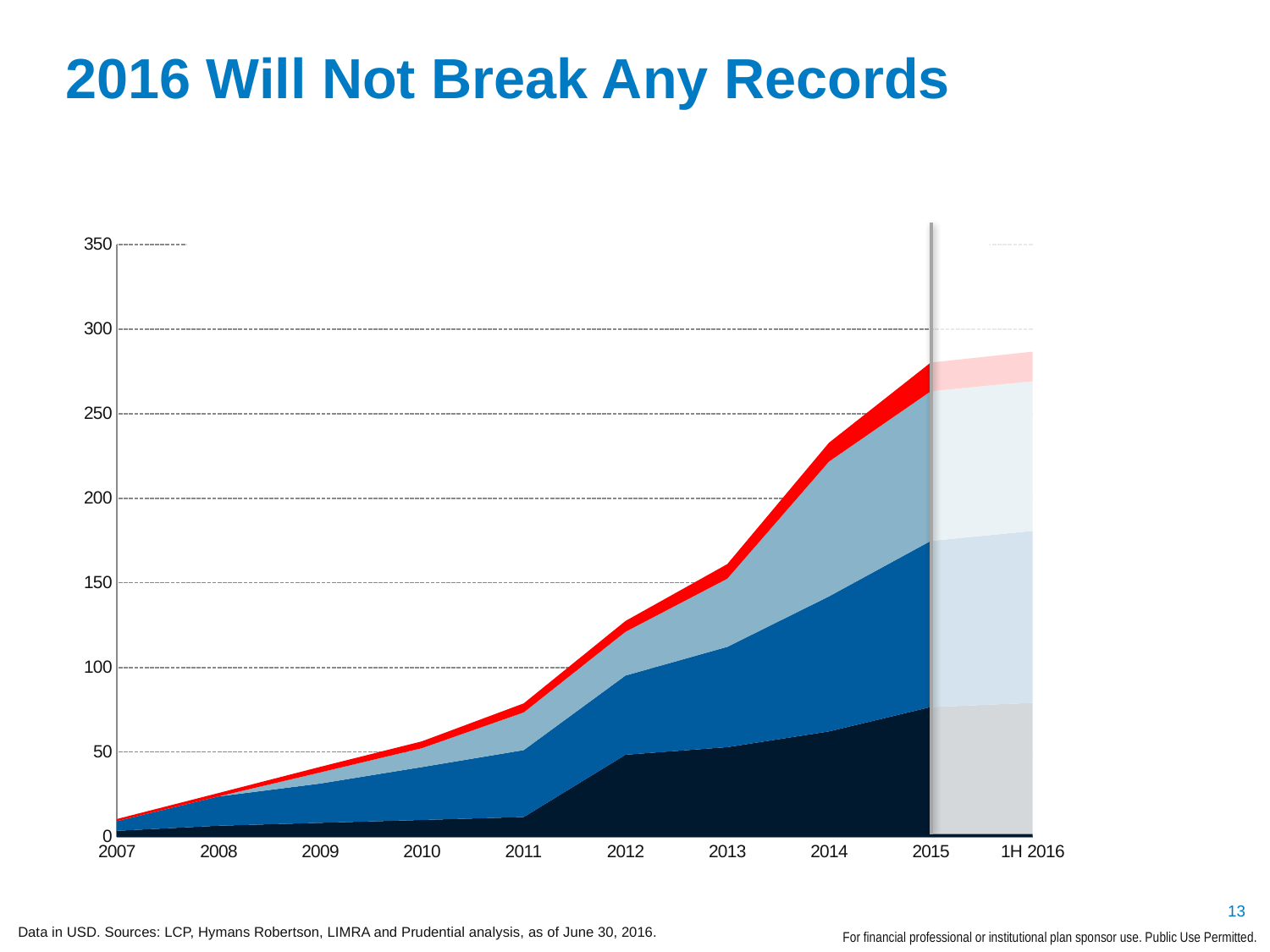
Is the stacked total for 2015 greater or less than 250? greater Which year has the lowest stacked total? 2007 What kind of chart is shown on the slide? Stacked area chart Is the stacked total for 2011 greater or less than 100? less Is the stacked total for 2012 greater or less than 100? greater What is the title of the slide's chart? 2016 Will Not Break Any Records What is the highest value shown on the y axis? 350 How many periods are labelled along the x axis? 10 Which has the larger stacked total, 2011 or 2012? 2012 Which has the larger stacked total, 2013 or 2014? 2014 Do the stacked totals generally rise or fall from 2007 to 2015? Rise